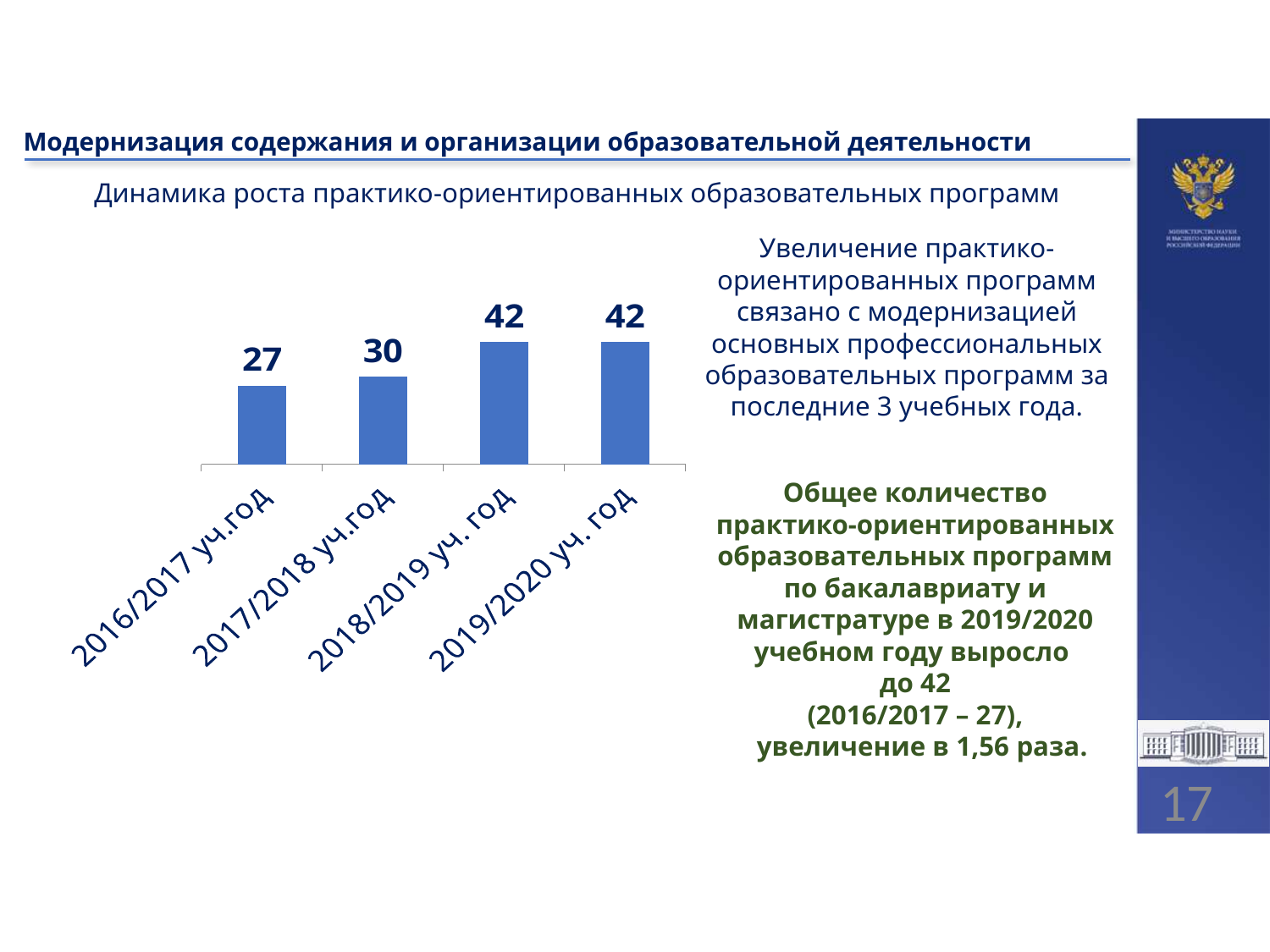
What is the value for 2018/2019 уч. год? 42 What is the value for 2019/2020 уч. год? 42 Do the values rise or fall from 2016/2017 уч.год to 2018/2019 уч. год? rise What is the value for 2016/2017 уч.год? 27 What kind of chart is shown on the slide? bar chart Which is larger, the value for 2017/2018 уч.год or the value for 2018/2019 уч. год? 2018/2019 уч. год What is the difference between the values for 2017/2018 уч.год and 2016/2017 уч.год? 3 What is the title of the chart? Динамика роста практико-ориентированных образовательных программ Which category has the lowest value? 2016/2017 уч.год What is the value for 2017/2018 уч.год? 30 What is the difference between the values for 2018/2019 уч. год and 2016/2017 уч.год? 15 How many categories are shown on the x axis? 4